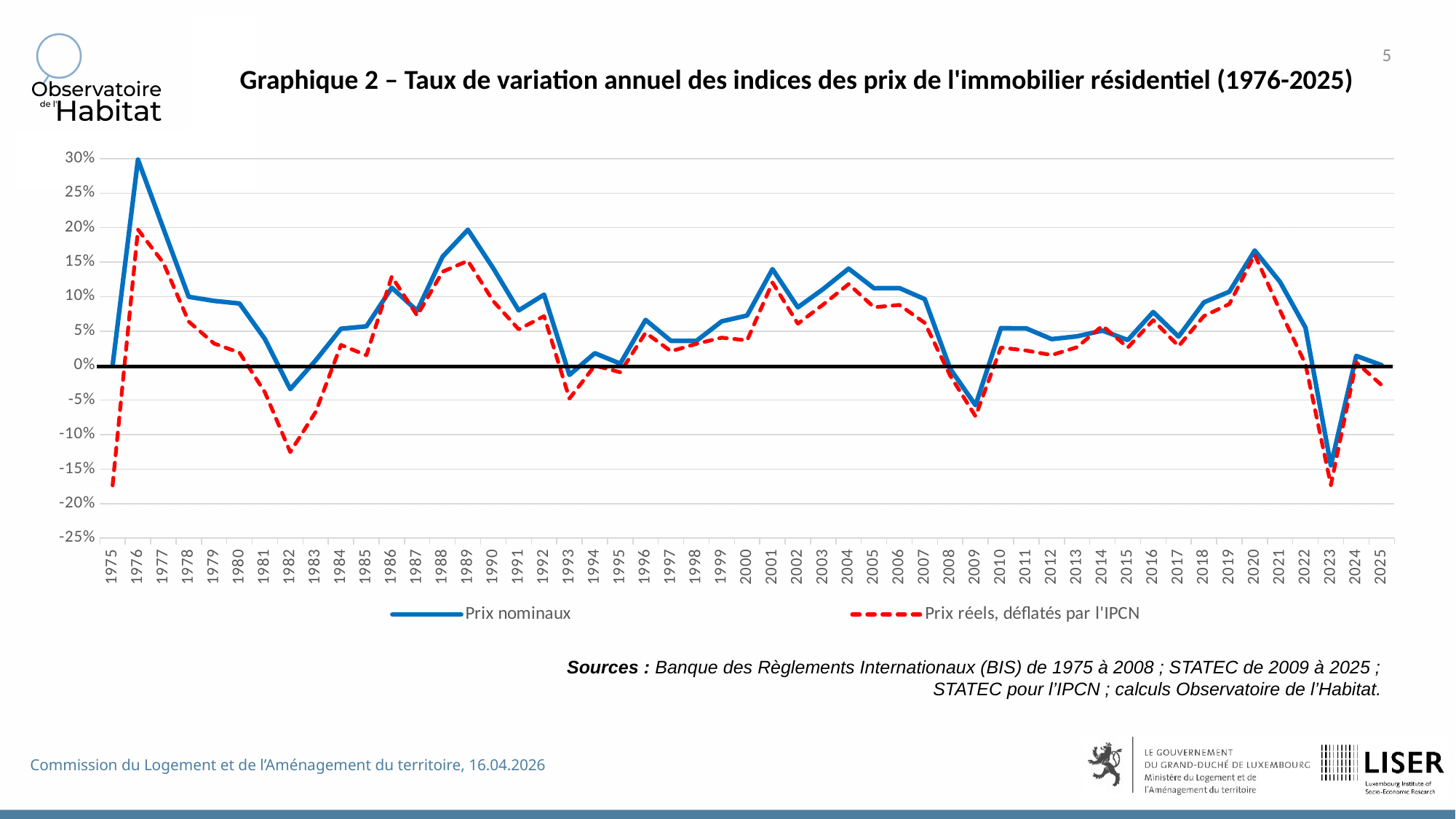
Is the value for Prix réels, déflatés par l'IPCN in 1982 greater or less than -10%? less In which year does the Prix nominaux series reach its lowest value? 2023 What kind of chart is shown on the slide? line chart What are the two series named in the legend? Prix nominaux; Prix réels, déflatés par l'IPCN How many years are shown on the x axis? 51 Does the Prix nominaux series rise or fall between 2020 and 2023? fall In which year does the Prix nominaux series reach its highest value? 1976 Is the value for Prix nominaux in 1976 greater or less than 25%? greater In 1989, which series has the larger value, Prix nominaux or Prix réels, déflatés par l'IPCN? Prix nominaux How many series does the legend list? 2 Is the value for Prix nominaux in 2023 greater or less than -10%? less In which year does the Prix réels, déflatés par l'IPCN series reach its highest value? 1976